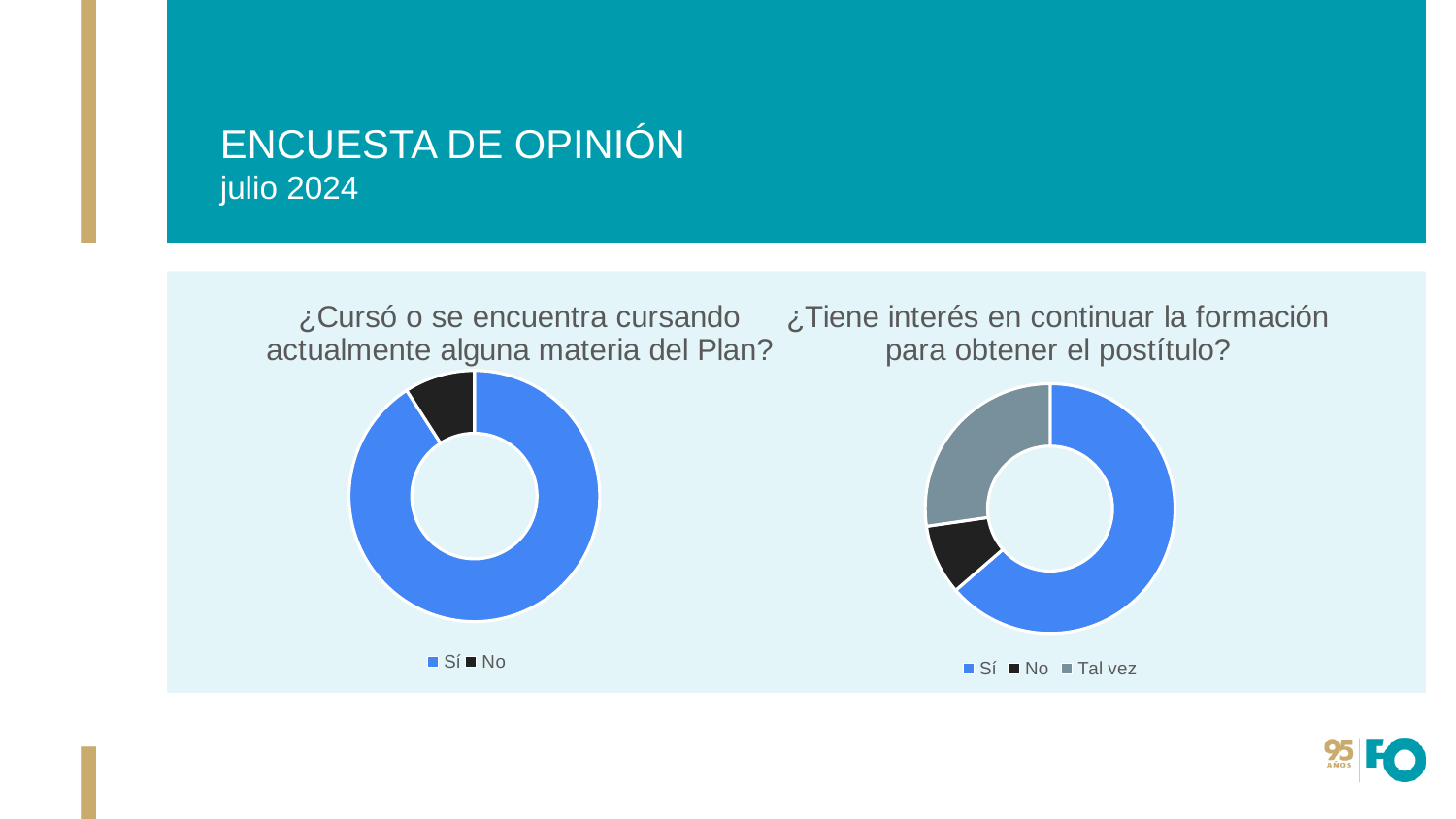
How many slices does the chart '¿Tiene interés en continuar la formación para obtener el postítulo?' have? 3 What kind of chart is used for '¿Tiene interés en continuar la formación para obtener el postítulo?'? Doughnut (pie) chart In the chart '¿Cursó o se encuentra cursando actualmente alguna materia del Plan?', which response has the smallest share? No In the chart '¿Tiene interés en continuar la formación para obtener el postítulo?', which response has the largest share? Sí How many categories does the legend of the chart '¿Cursó o se encuentra cursando actualmente alguna materia del Plan?' list? 2 In the chart '¿Cursó o se encuentra cursando actualmente alguna materia del Plan?', which response has the largest share? Sí What is the title and date shown in the slide header? ENCUESTA DE OPINIÓN, julio 2024 What kind of chart is used for '¿Cursó o se encuentra cursando actualmente alguna materia del Plan?'? Doughnut (pie) chart In the chart '¿Tiene interés en continuar la formación para obtener el postítulo?', which is larger: 'Tal vez' or 'No'? Tal vez In the chart '¿Tiene interés en continuar la formación para obtener el postítulo?', what colour represents 'Tal vez'? Grey In the chart '¿Tiene interés en continuar la formación para obtener el postítulo?', which response has the smallest share? No How many categories does the legend of the chart '¿Tiene interés en continuar la formación para obtener el postítulo?' list? 3